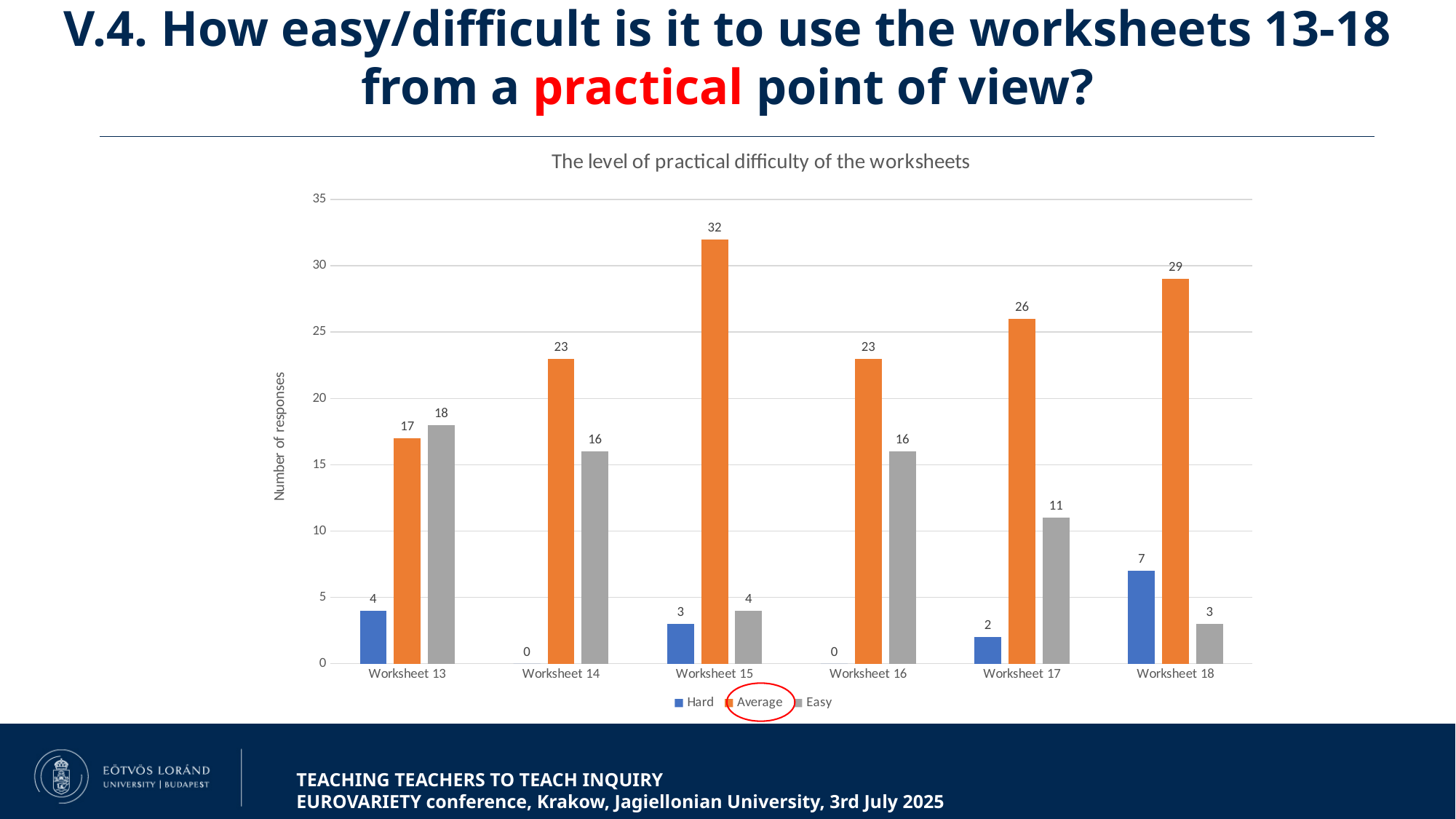
How many worksheets are shown on the x axis? 6 How many series does the legend list? 3 What is the difference between the Average values for Worksheet 15 and Worksheet 14? 9 What is the title of the chart? The level of practical difficulty of the worksheets What is the value for Hard for Worksheet 18? 7 Which is larger for Worksheet 13: the Hard value or the Easy value? Easy What is the value for Average for Worksheet 15? 32 What kind of chart is shown on the slide? Bar chart Which worksheet has the lowest Easy value? Worksheet 18 What is the total of the Hard, Average and Easy values for Worksheet 17? 39 What is the value for Easy for Worksheet 13? 18 Which worksheet has the highest Average value? Worksheet 15